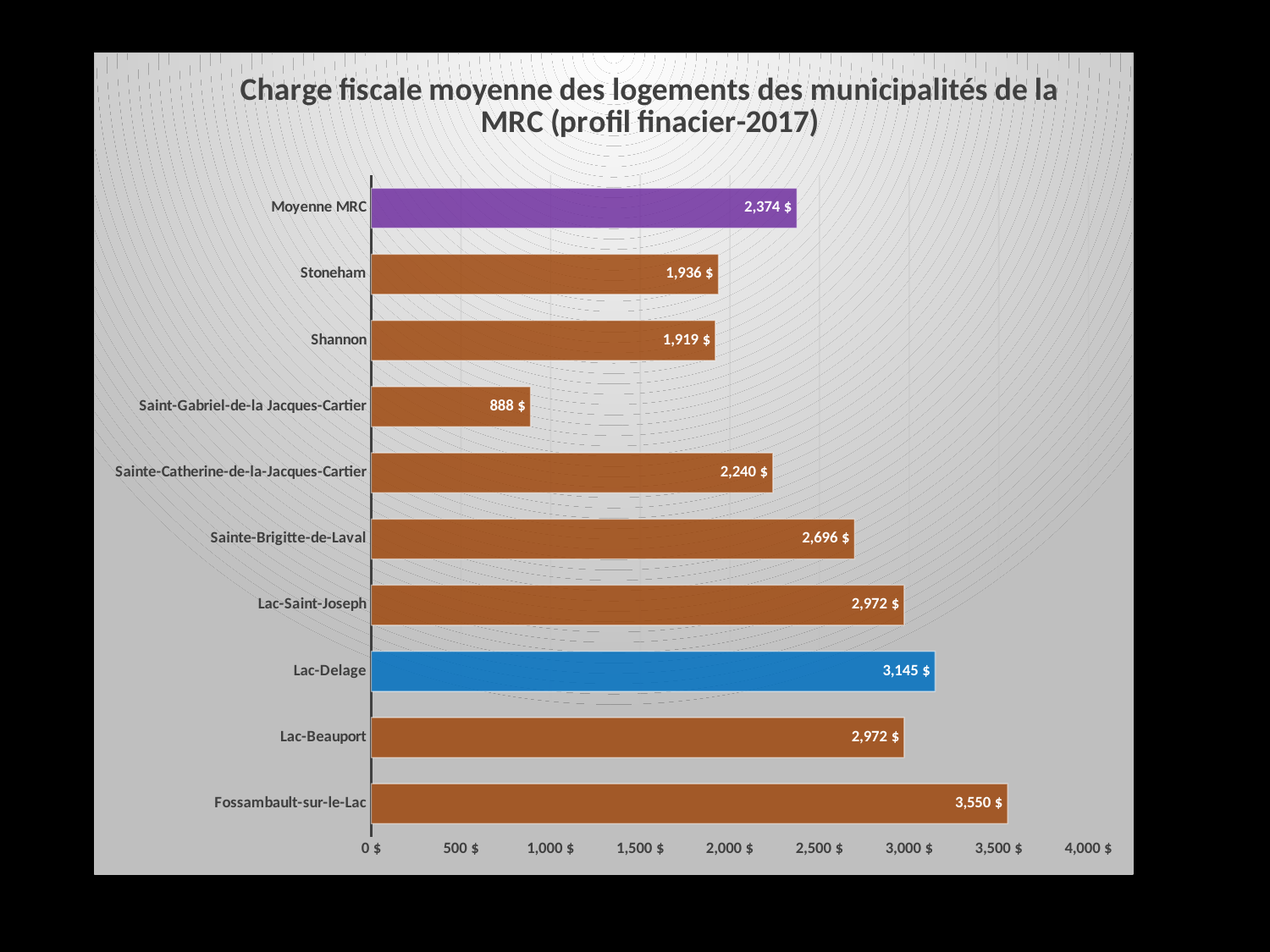
What kind of chart is shown on the slide? bar chart What is the title of the chart? Charge fiscale moyenne des logements des municipalités de la MRC (profil finacier-2017) Which category has the lowest value? Saint-Gabriel-de-la Jacques-Cartier How many categories are shown on the chart? 10 What is the difference between the values for Fossambault-sur-le-Lac and Lac-Delage? 405 $ Which is larger, the value for Stoneham or the value for Sainte-Catherine-de-la-Jacques-Cartier? Sainte-Catherine-de-la-Jacques-Cartier Is the value for Lac-Saint-Joseph greater or less than 2,500 $? greater Which category has the highest value? Fossambault-sur-le-Lac What is the difference between the values for Sainte-Brigitte-de-Laval and Sainte-Catherine-de-la-Jacques-Cartier? 456 $ What is the value for Saint-Gabriel-de-la Jacques-Cartier? 888 $ What is the value for Lac-Delage? 3,145 $ What is the value for Moyenne MRC? 2,374 $